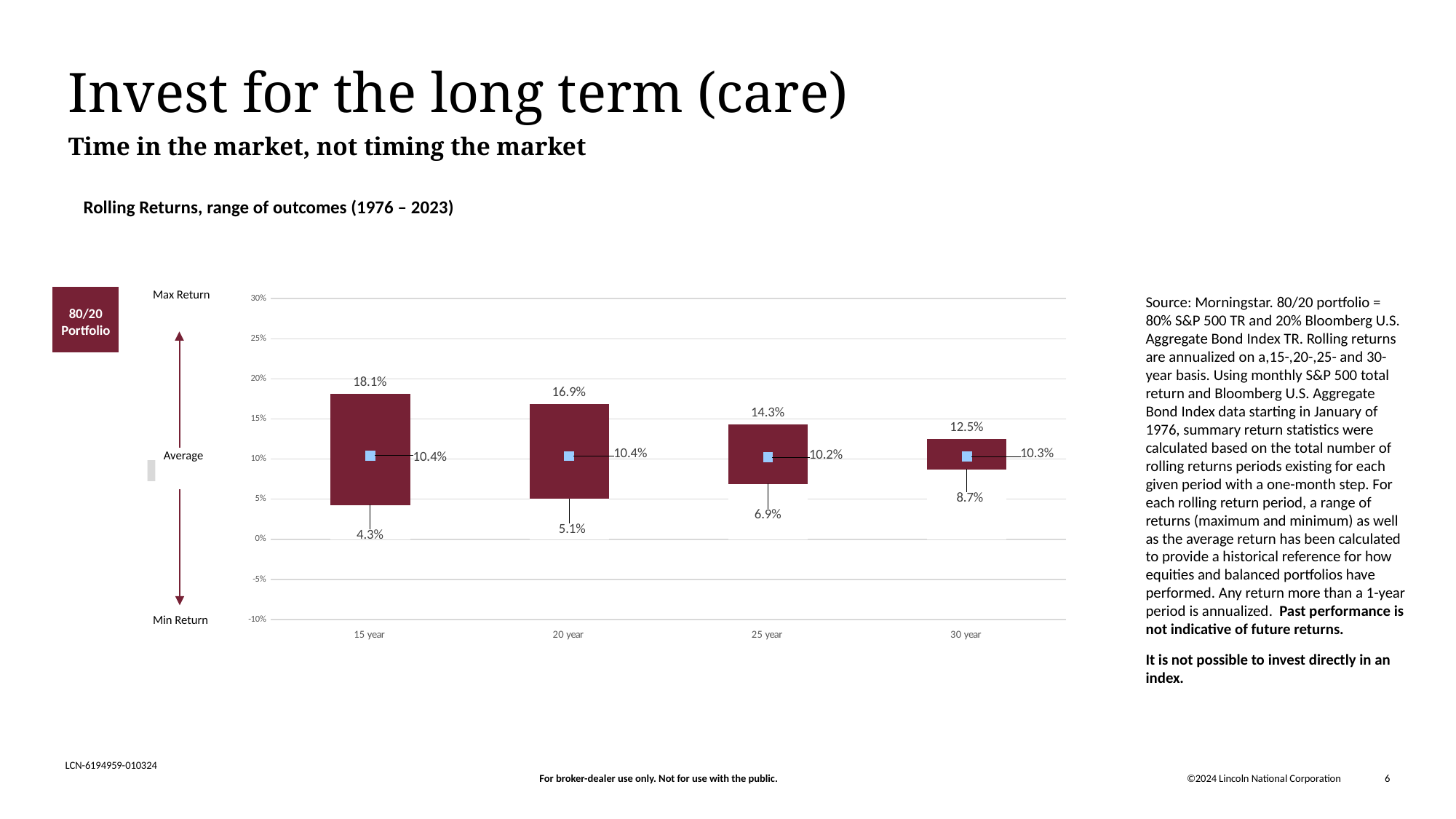
What is the average rolling return shown for the 25 year period? 10.2% What is the minimum rolling return shown for the 30 year period? 8.7% What is the minimum rolling return shown for the 20 year period? 5.1% Which is larger, the maximum return for the 20 year period or the maximum return for the 30 year period? 20 year What is the title of the chart? Rolling Returns, range of outcomes (1976 – 2023) Which rolling period has the lowest minimum return? 15 year How many rolling return periods are shown on the x axis? 4 What is the difference between the maximum and minimum return for the 25 year period? 7.4% What is the maximum rolling return shown for the 15 year period? 18.1% Which rolling period has the highest maximum return? 15 year What portfolio does the chart represent, according to the label to the left of the chart? 80/20 Portfolio Do the maximum returns rise or fall as the rolling period lengthens from 15 year to 30 year? fall